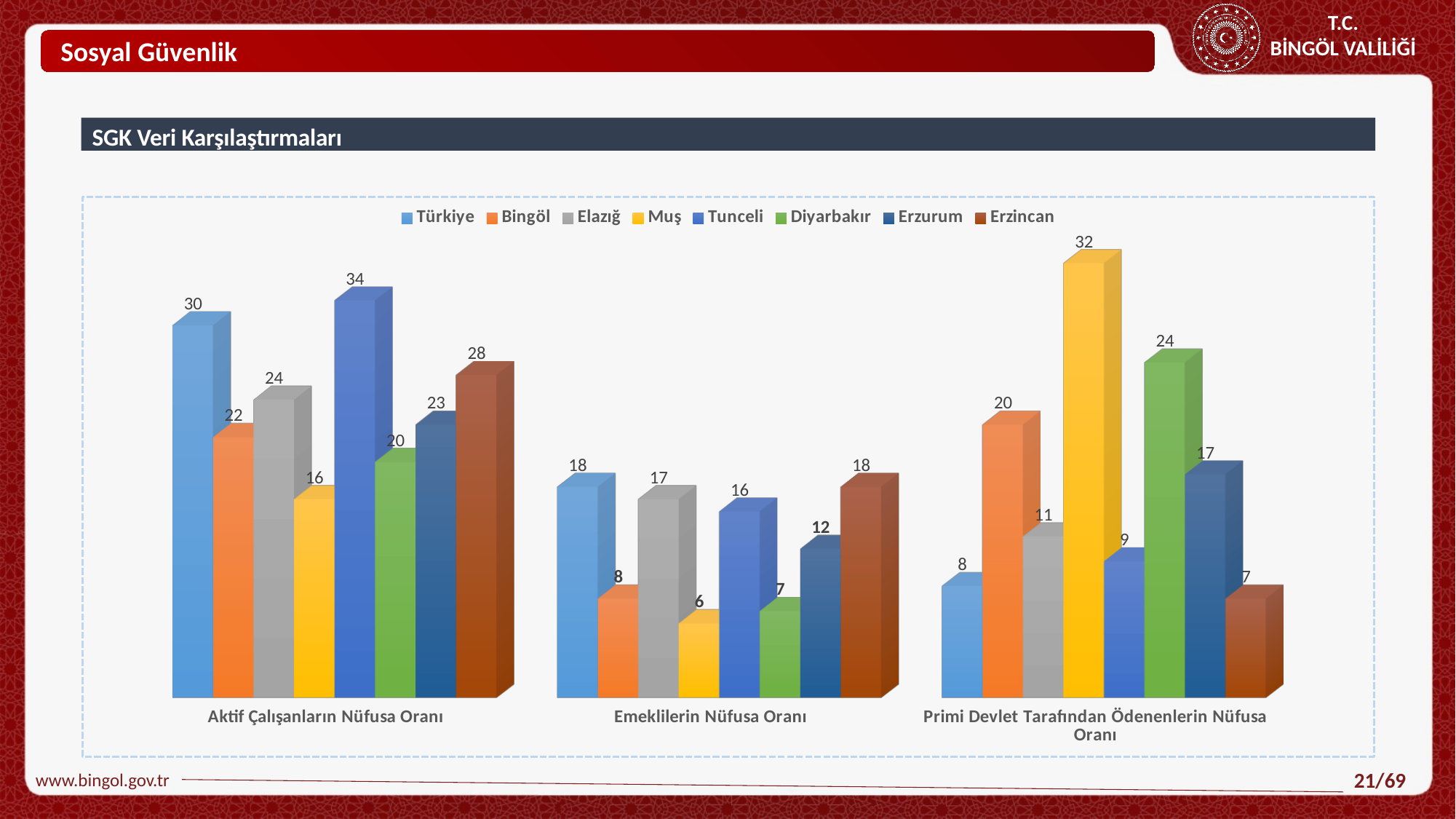
What is the value for Bingöl in the Emeklilerin Nüfusa Oranı category? 8 What is the difference between the Tunceli and Türkiye values in the Aktif Çalışanların Nüfusa Oranı category? 4 What is the difference between the Bingöl and Türkiye values in the Primi Devlet Tarafından Ödenenlerin Nüfusa Oranı category? 12 In the Emeklilerin Nüfusa Oranı category, which is larger: Elazığ or Erzurum? Elazığ Which series has the highest value in the Primi Devlet Tarafından Ödenenlerin Nüfusa Oranı category? Muş How many series does the legend list? 8 What is the value for Muş in the Primi Devlet Tarafından Ödenenlerin Nüfusa Oranı category? 32 What is the value for Erzincan in the Aktif Çalışanların Nüfusa Oranı category? 28 Which series has the lowest value in the Emeklilerin Nüfusa Oranı category? Muş What kind of chart is shown on the slide? Bar chart How many categories are shown on the x axis? 3 What is the value for Tunceli in the Aktif Çalışanların Nüfusa Oranı category? 34